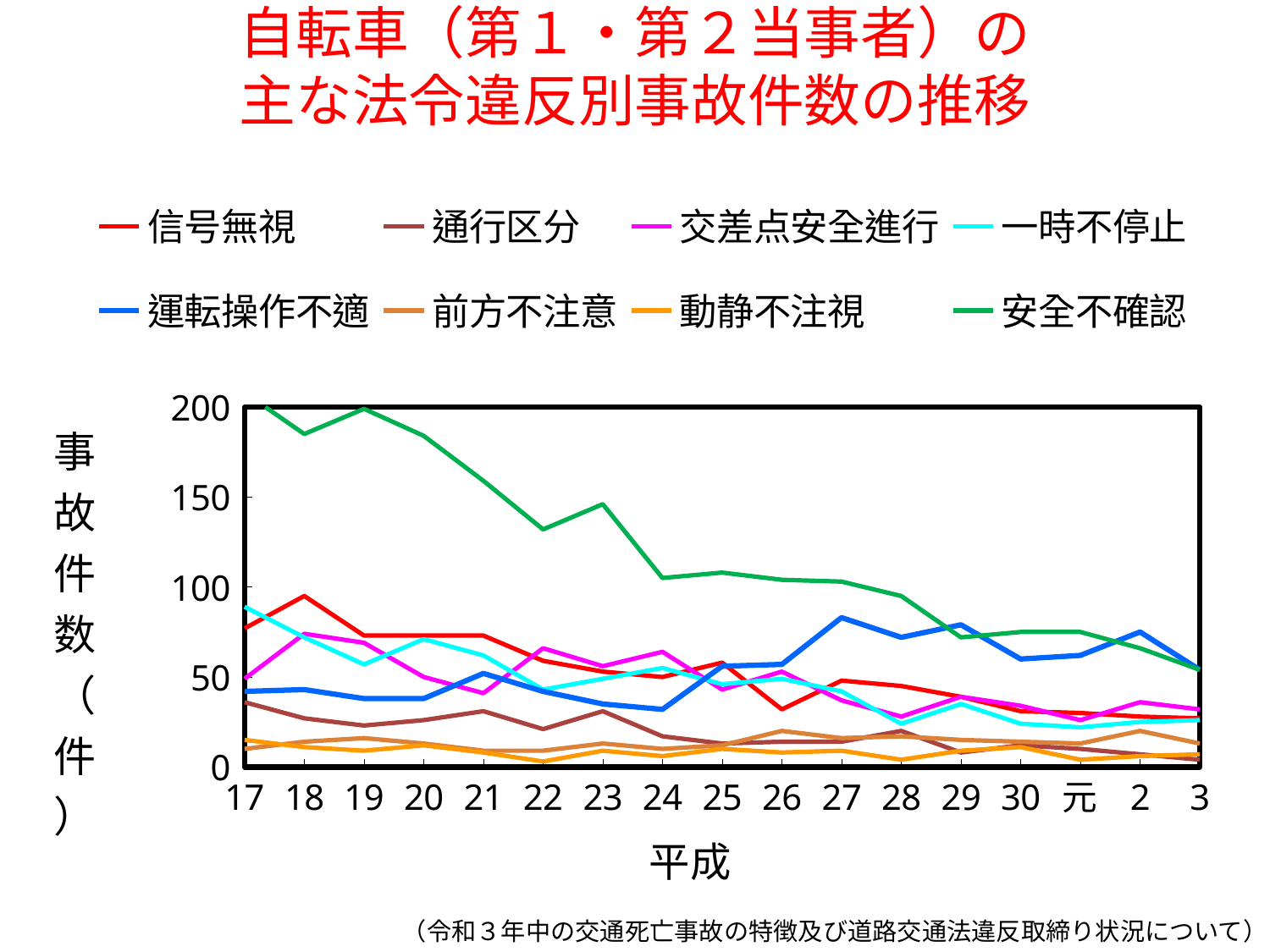
Is the value for 安全不確認 at 平成17 greater or less than 150? greater How many series does the legend list? 8 What colour is the line for 安全不確認? green Does the value for 安全不確認 rise or fall overall from 平成17 to 令和3? fall What kind of chart is shown on the slide? line chart Is the value for 安全不確認 at 平成22 greater or less than 100? greater How many points are plotted along the x axis for each series? 17 At 平成27, which is larger: 運転操作不適 or 信号無視? 運転操作不適 Which series has the highest value at 平成17? 安全不確認 What is the label on the x axis of the chart? 平成 Is the value for 通行区分 at 令和3 greater or less than 50? less